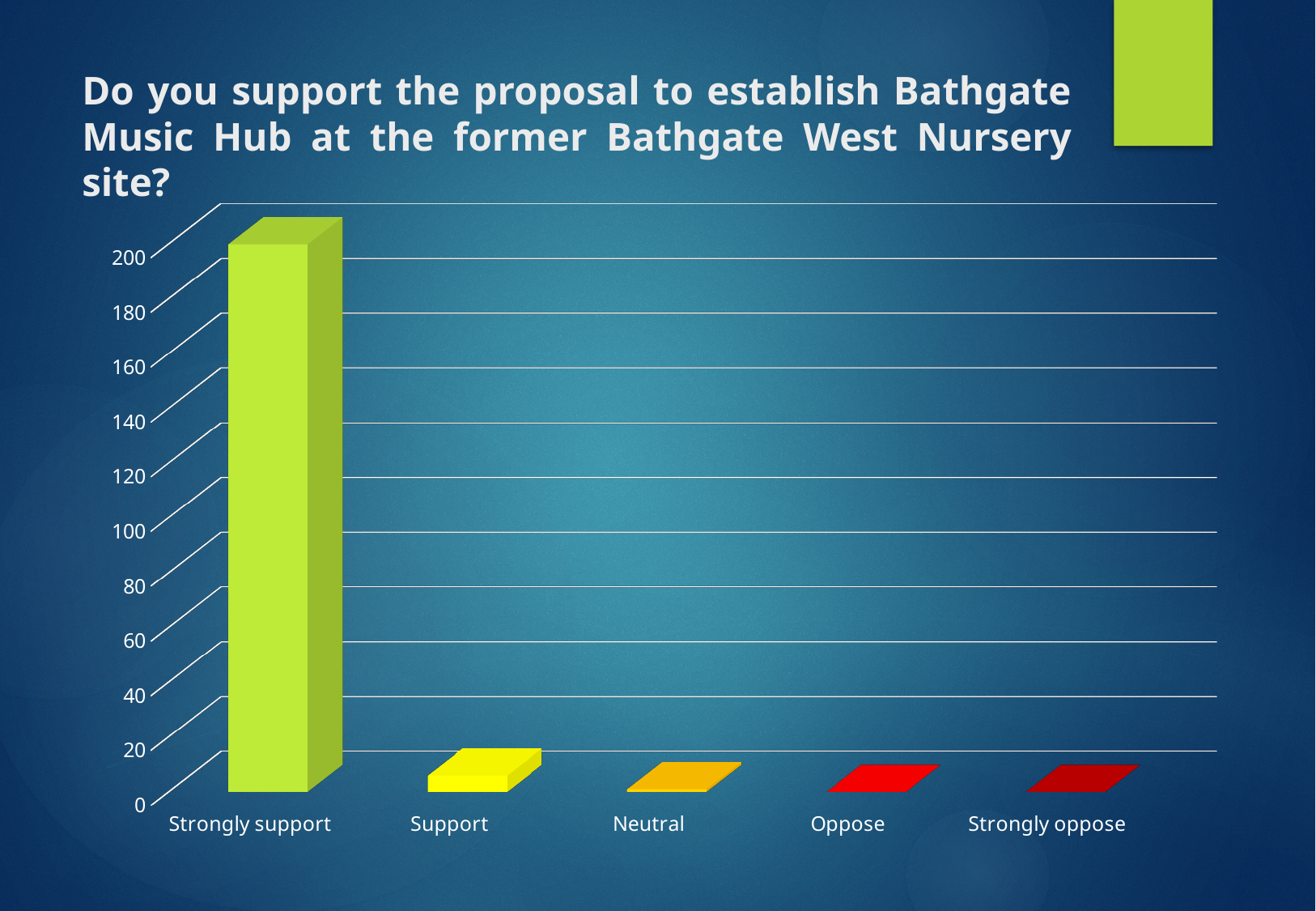
Which is larger, the value for Strongly support or the value for Support? Strongly support How many categories are shown on the x axis? 5 What kind of chart is shown on the slide? bar chart Do the values rise or fall moving from Strongly support to Strongly oppose along the x axis? fall Is the value for Neutral greater or less than 20? less Is the value for Strongly oppose greater or less than 20? less Is the value for Strongly support greater or less than 180? greater What is the title of the chart? Do you support the proposal to establish Bathgate Music Hub at the former Bathgate West Nursery site? What colour is the bar for Strongly support? green Which category has the highest value? Strongly support